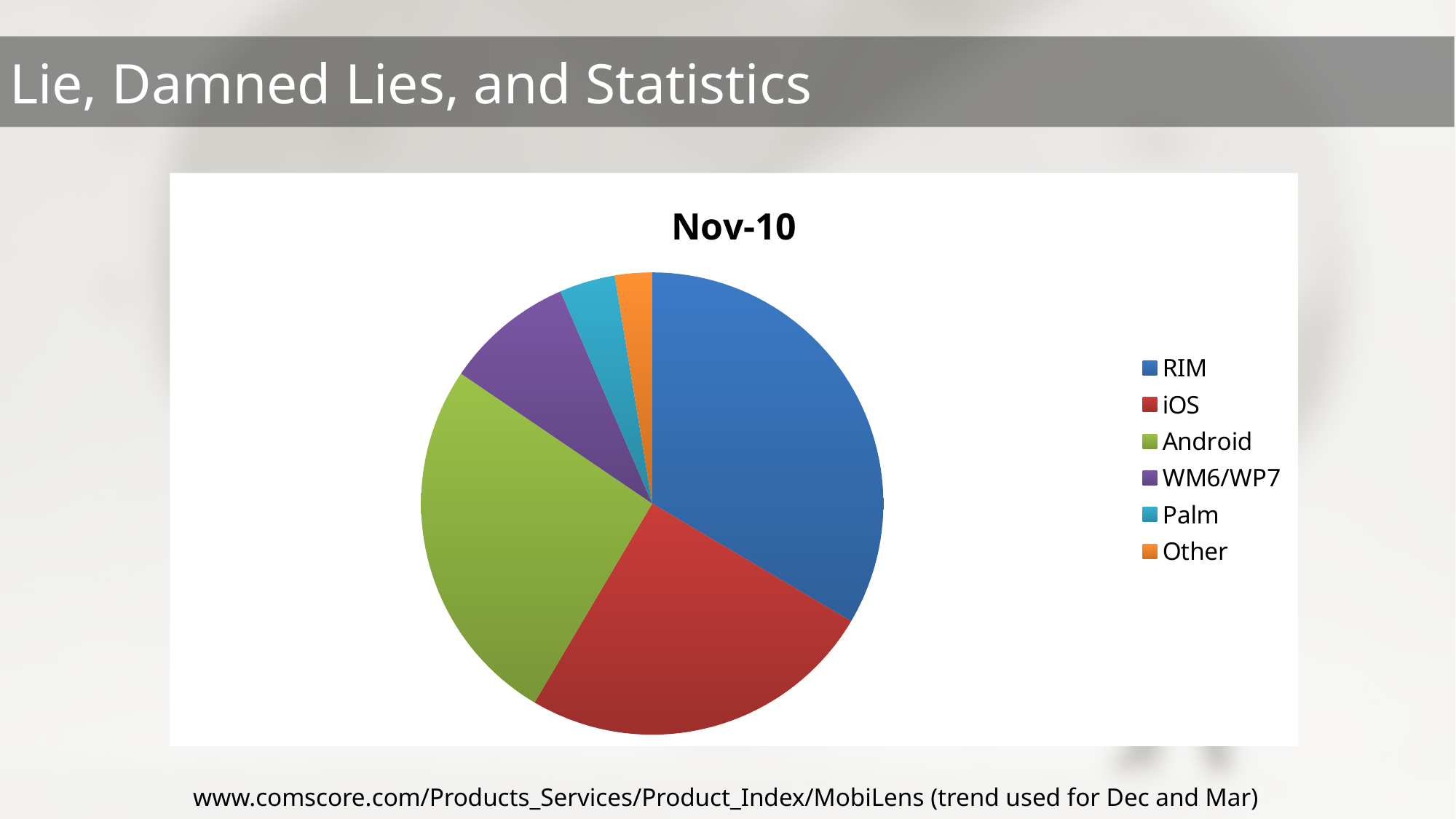
What kind of chart is shown on the slide? pie chart How many entries does the legend list? 6 How many slices does the pie chart have? 6 Which slice is larger, WM6/WP7 or Palm? WM6/WP7 Which slice is larger, Android or WM6/WP7? Android Which category has the largest slice of the pie? RIM What is the title of the chart? Nov-10 Which slice is larger, iOS or Palm? iOS Which category has the smallest slice of the pie? Other What colour is the Android slice in the pie chart? green